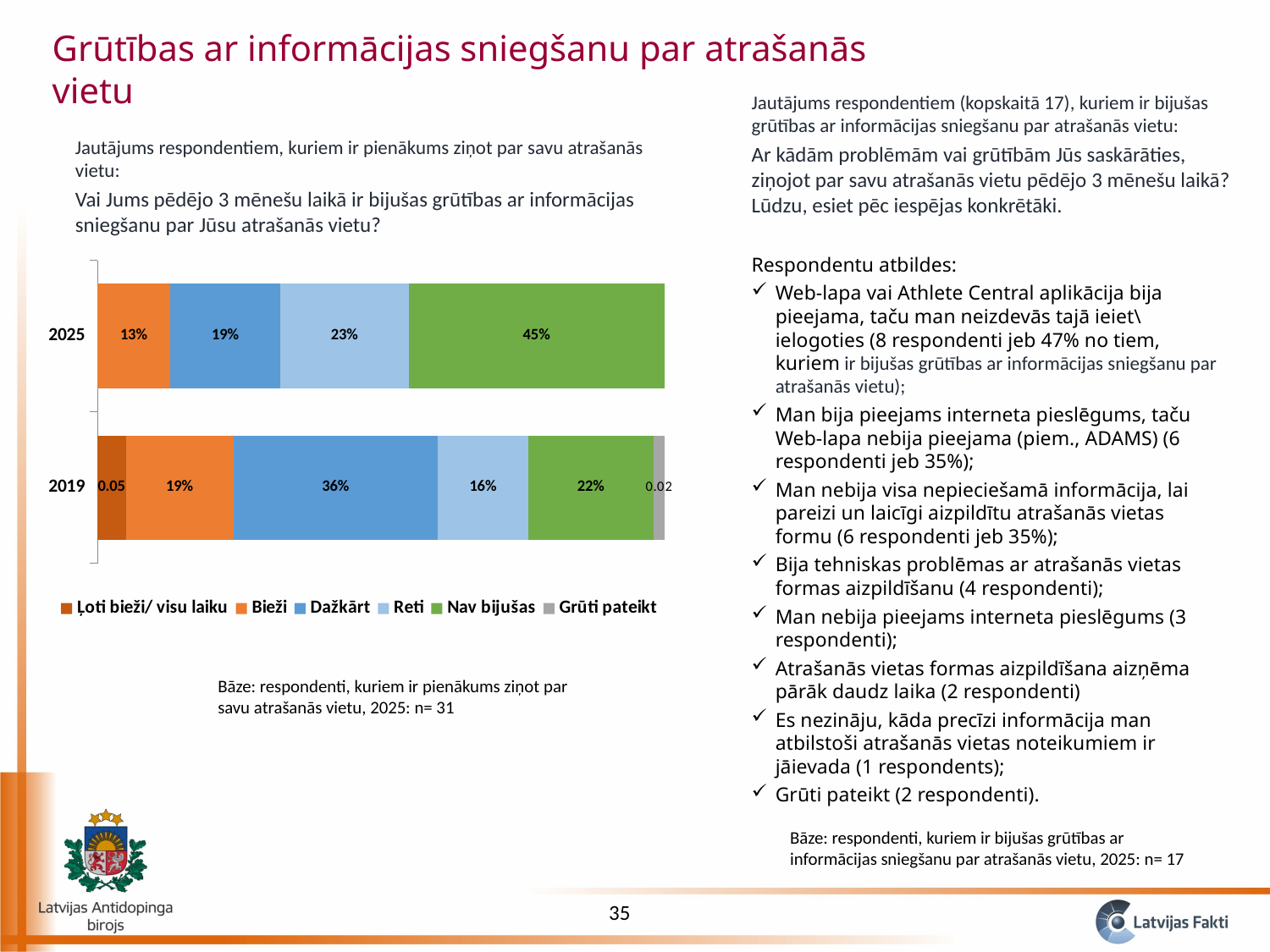
What is the first entry in the chart legend? Ļoti bieži/ visu laiku What is the difference between the "Nav bijušas" values for 2025 and 2019? 23 percentage points Which is larger: the "Dažkārt" value in 2019 or in 2025? 2019 Which response category has the largest share in the 2019 bar? Dažkārt What is the value for "Nav bijušas" in 2025? 45% What is the value for "Reti" in 2025? 23% Which response category has the largest share in the 2025 bar? Nav bijušas How many years (categories) are plotted in the chart? 2 What kind of chart is shown on the slide? stacked bar chart What is the value for "Bieži" in 2019? 19% What is the value for "Dažkārt" in 2019? 36% How many series does the chart legend list? 6